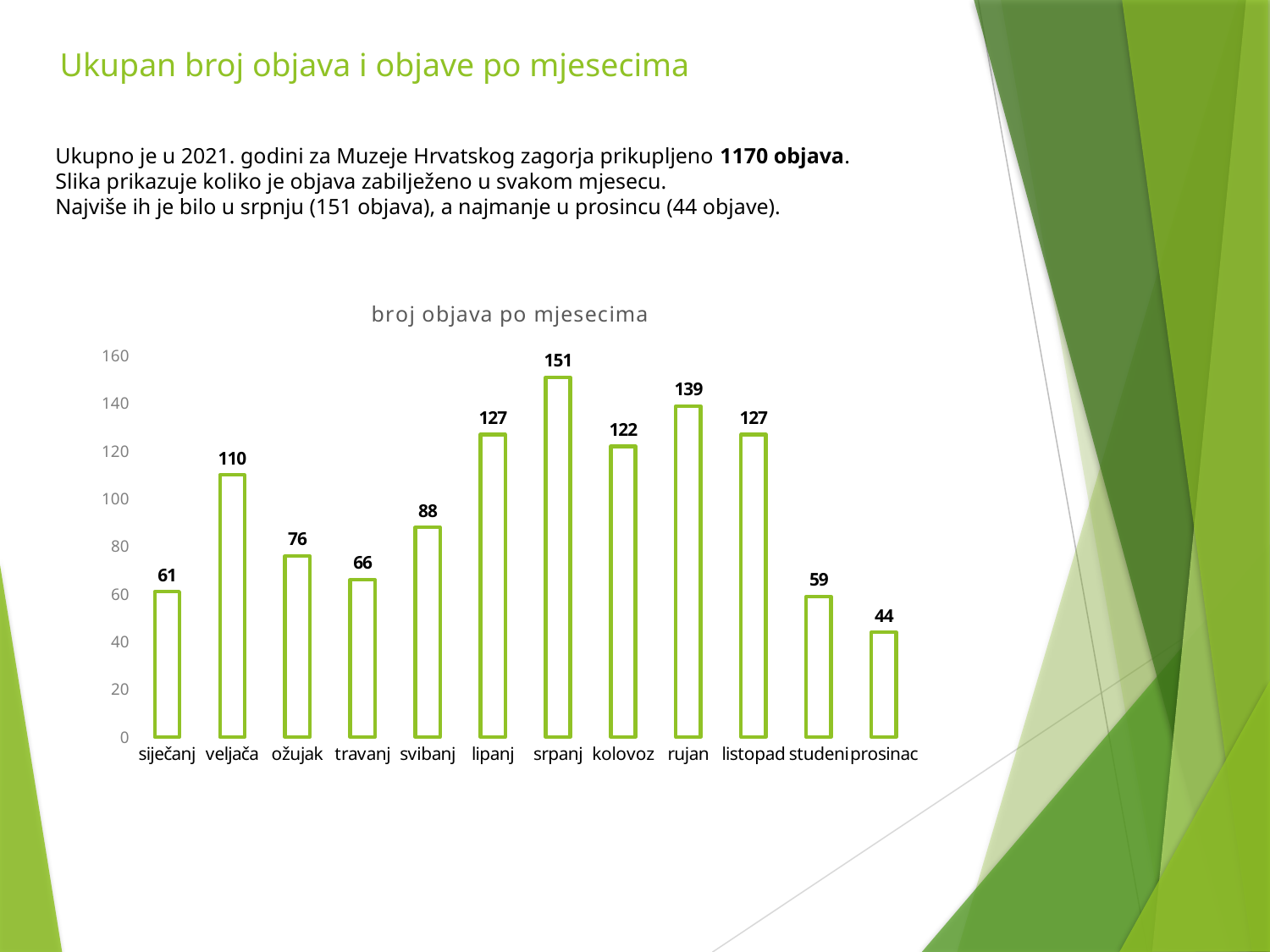
What is the value for veljača? 110 What kind of chart is shown on the slide? bar chart Which month has the highest number of posts? srpanj Which is larger, the value for svibanj or the value for ožujak? svibanj How many months are shown on the x axis? 12 What is the difference between the values for srpanj and prosinac? 107 Is the value for rujan greater or less than 120? greater What is the difference between the values for rujan and kolovoz? 17 What is the value for prosinac? 44 What is the value for srpanj? 151 What is the title of the chart? broj objava po mjesecima Which month has the lowest number of posts? prosinac